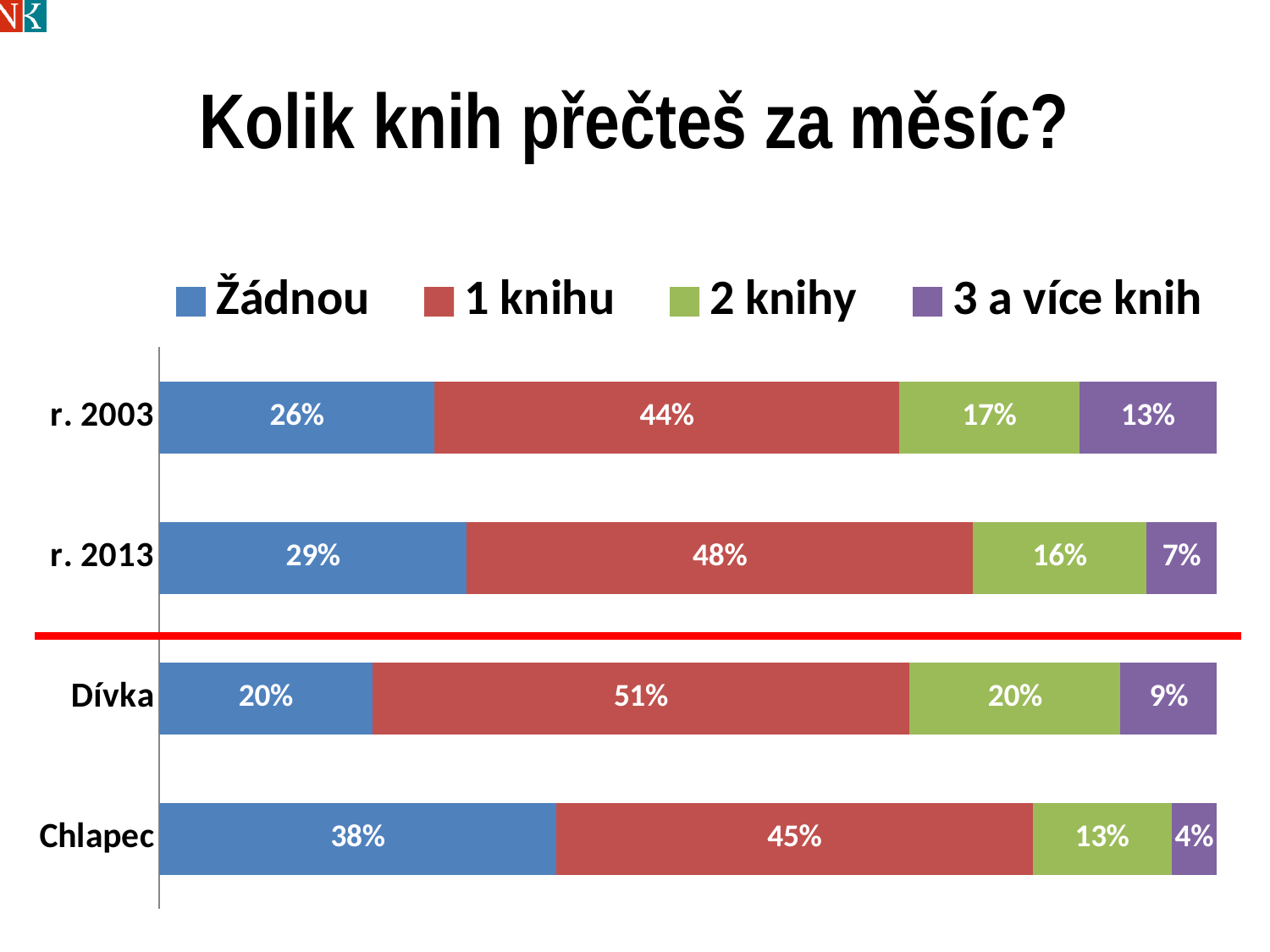
What is the value for '1 knihu' in the Dívka bar? 51% What kind of chart is shown on the slide? Stacked bar chart Which category has the lowest value for '3 a více knih'? Chlapec What is the value for '3 a více knih' for Chlapec? 4% What is the value for '2 knihy' in r. 2013? 16% How many series does the legend list? 4 How many categories (bars) are shown in the chart? 4 Which is larger: the 'Žádnou' value for Dívka or for Chlapec? Chlapec What is the difference between the '1 knihu' values for r. 2013 and r. 2003? 4% What is the title of the slide? Kolik knih přečteš za měsíc? Which category has the highest value for 'Žádnou'? Chlapec What percentage of respondents in r. 2003 read 'Žádnou' (no books)? 26%